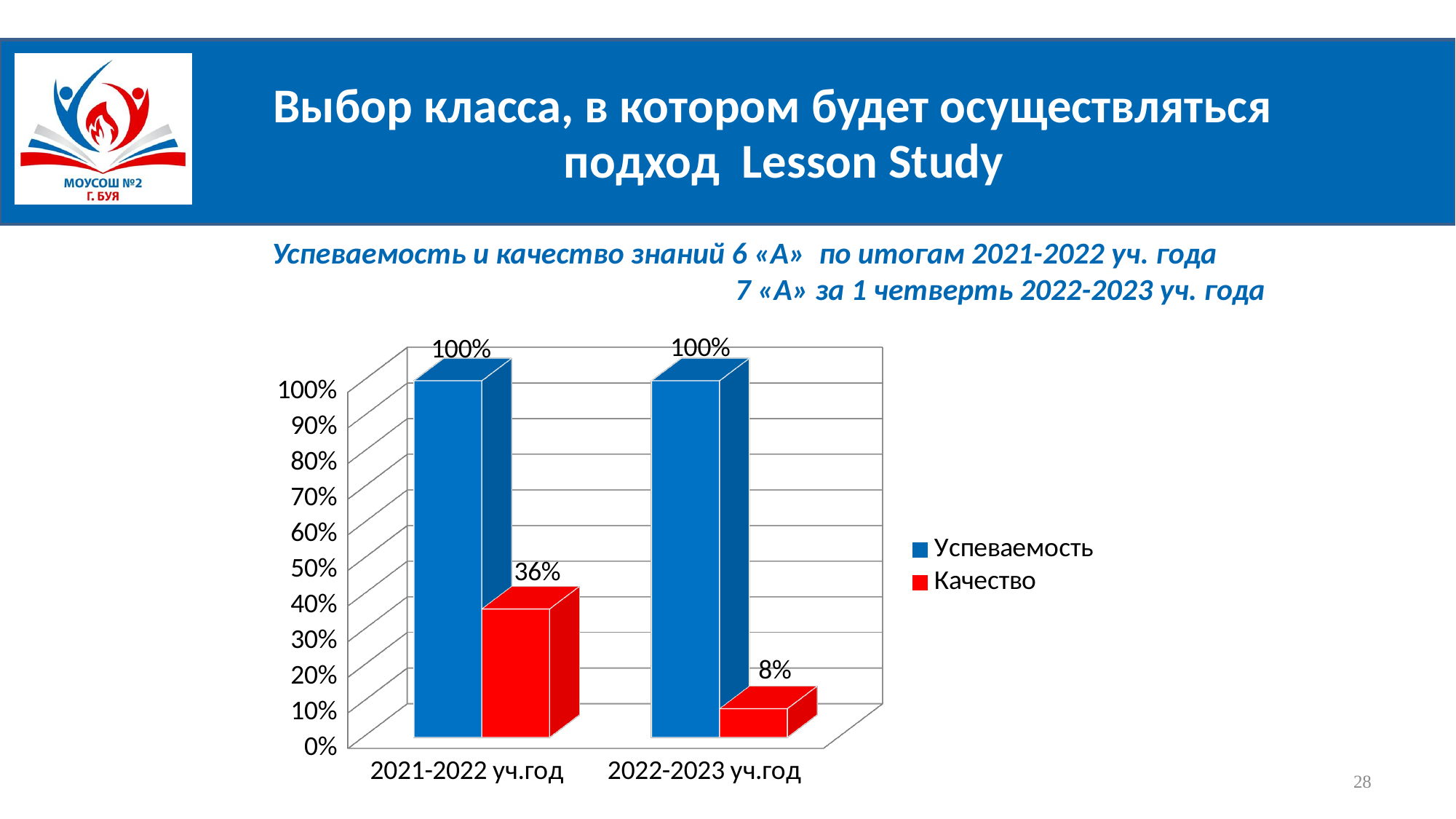
Which category has the highest Качество value? 2021-2022 уч.год What is the value of Успеваемость for 2022-2023 уч.год? 100% Does the Качество value rise or fall from 2021-2022 уч.год to 2022-2023 уч.год? Fall What is the value of Качество for 2022-2023 уч.год? 8% What is the value of Качество for 2021-2022 уч.год? 36% Which is larger: Качество for 2021-2022 уч.год or Качество for 2022-2023 уч.год? 2021-2022 уч.год What kind of chart is shown on the slide? Bar chart What is the difference between the Качество values for 2021-2022 уч.год and 2022-2023 уч.год? 28% What is the value of Успеваемость for 2021-2022 уч.год? 100% How many series does the legend list? 2 How many categories are shown on the x axis? 2 Which category has the lowest Качество value? 2022-2023 уч.год